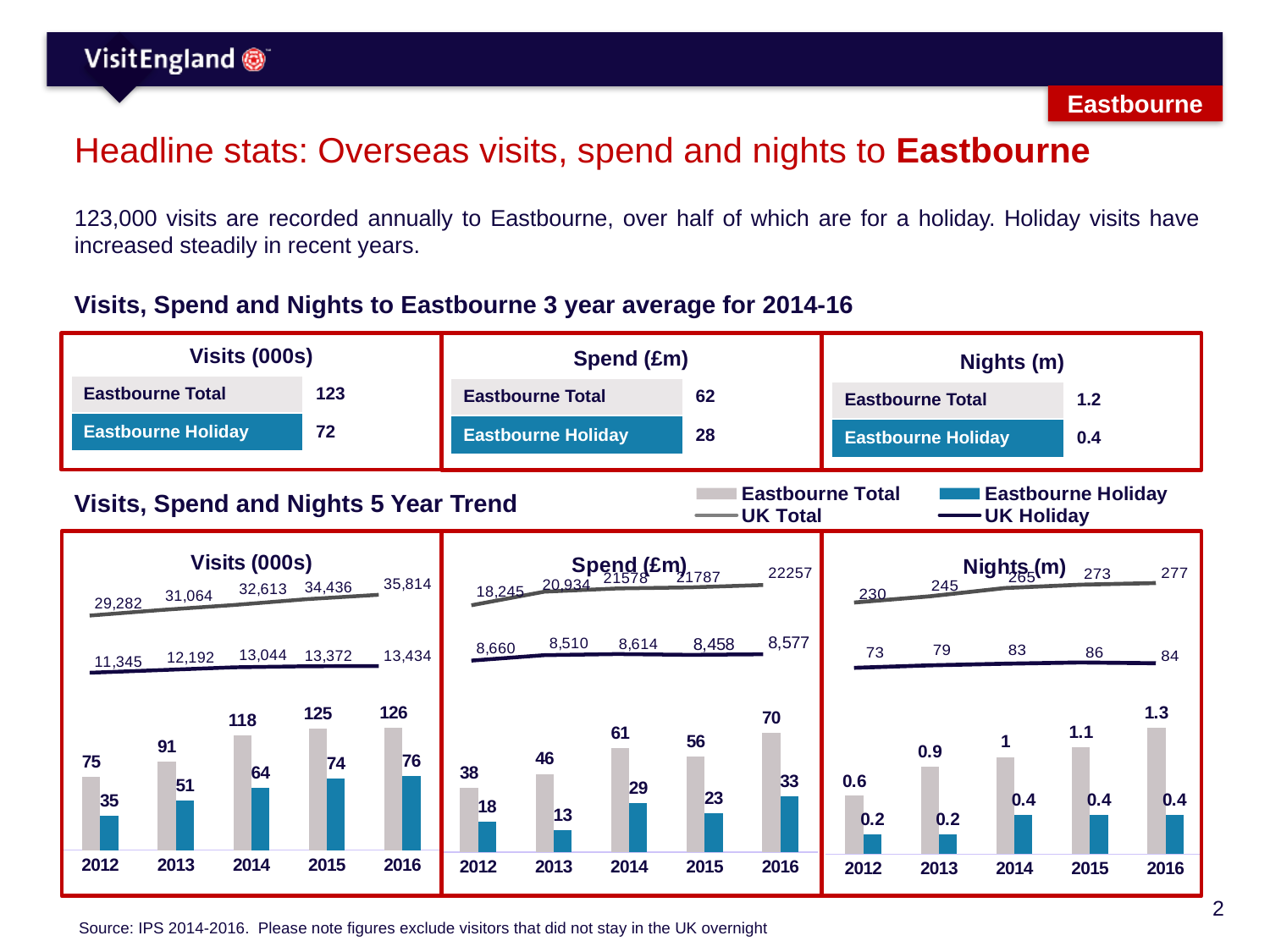
In the Visits (000s) trend chart, what is the difference between the Eastbourne Total and Eastbourne Holiday values for 2016? 50 In the Spend (£m) trend chart, what is the UK Holiday value for 2012? 8,660 In the Visits (000s) trend chart, do the Eastbourne Total values rise or fall from 2012 to 2016? rise In the Spend (£m) trend chart, which year has the highest Eastbourne Total value? 2016 How many years are shown on the x axis of the Visits (000s) trend chart? 5 In the Spend (£m) trend chart, which year has the larger Eastbourne Total value, 2014 or 2015? 2014 In the Nights (m) trend chart, what is the UK Total value for 2016? 277 In the 5 Year Trend legend, what colour represents Eastbourne Holiday? blue In the Visits (000s) trend chart, what is the Eastbourne Total value for 2014? 118 How many series does the legend for the 5 Year Trend charts list? 4 In the Nights (m) trend chart, which year has the lowest Eastbourne Total value? 2012 In the Spend (£m) trend chart, what is the Eastbourne Holiday value for 2013? 13